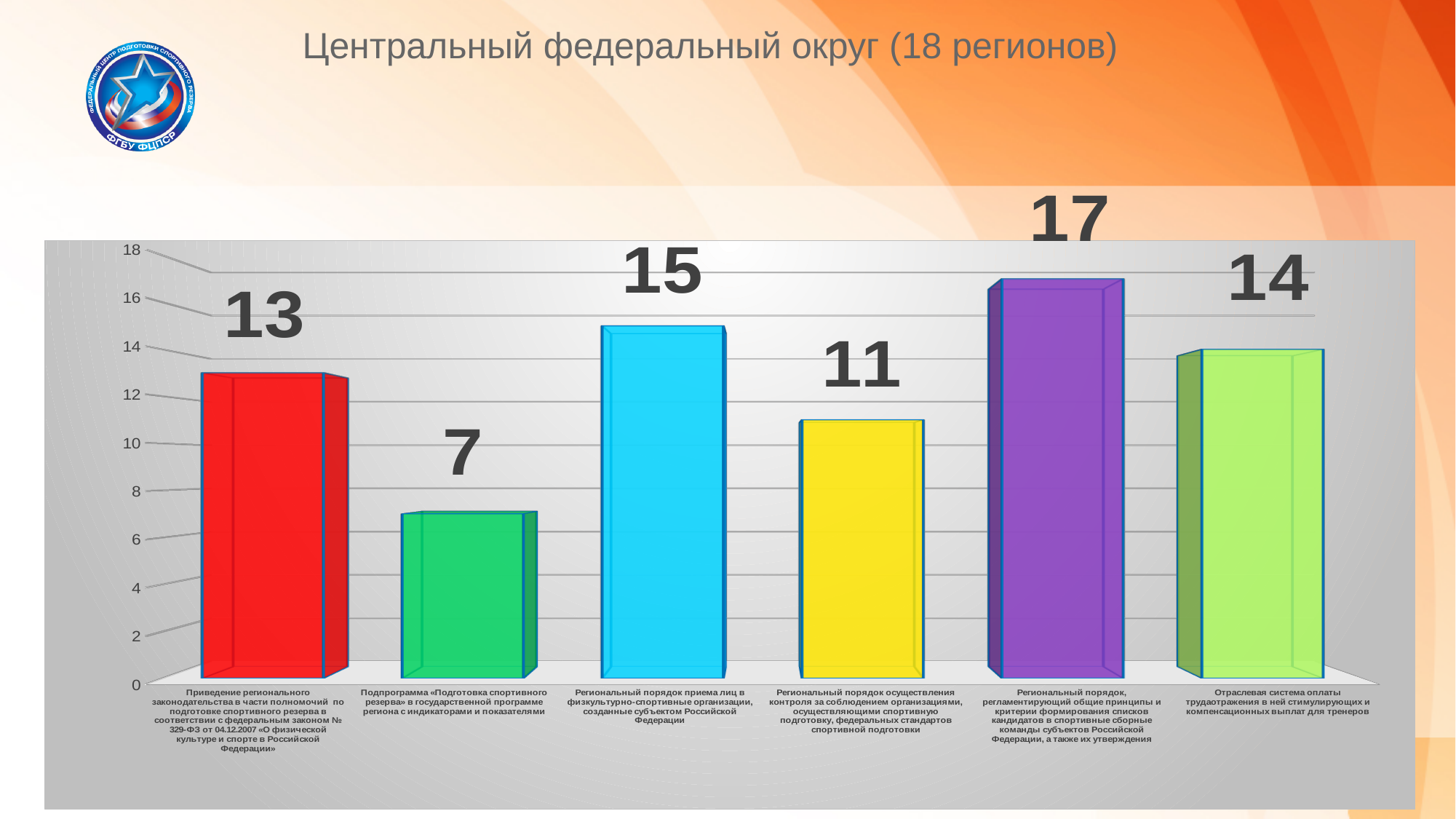
What kind of chart is shown on the slide? Bar chart How many categories (bars) are shown on the chart? 6 What value is shown for the bar labelled «Подпрограмма «Подготовка спортивного резерва» в государственной программе региона с индикаторами и показателями»? 7 Is the value for «Региональный порядок приема лиц в физкультурно-спортивные организации...» greater or less than 12? greater Which is larger: the value for «Приведение регионального законодательства...» or the value for «Отраслевая система оплаты труда...»? Отраслевая система оплаты труда... What value is shown for the bar labelled «Региональный порядок осуществления контроля за соблюдением организациями, осуществляющими спортивную подготовку, федеральных стандартов спортивной подготовки»? 11 What is the title of the slide? Центральный федеральный округ (18 регионов) What is the difference between the value for «Региональный порядок приема лиц в физкультурно-спортивные организации, созданные субъектом Российской Федерации» and the value for «Приведение регионального законодательства...»? 2 What value is shown for the bar labelled «Отраслевая система оплаты труда, отражения в ней стимулирующих и компенсационных выплат для тренеров»? 14 Which category has the lowest value on the chart? Подпрограмма «Подготовка спортивного резерва» в государственной программе региона с индикаторами и показателями Which category has the highest value on the chart? Региональный порядок, регламентирующий общие принципы и критерии формирования списков кандидатов в спортивные сборные команды субъектов Российской Федерации, а также их утверждения What is the difference between the highest value (17) and the lowest value (7) on the chart? 10